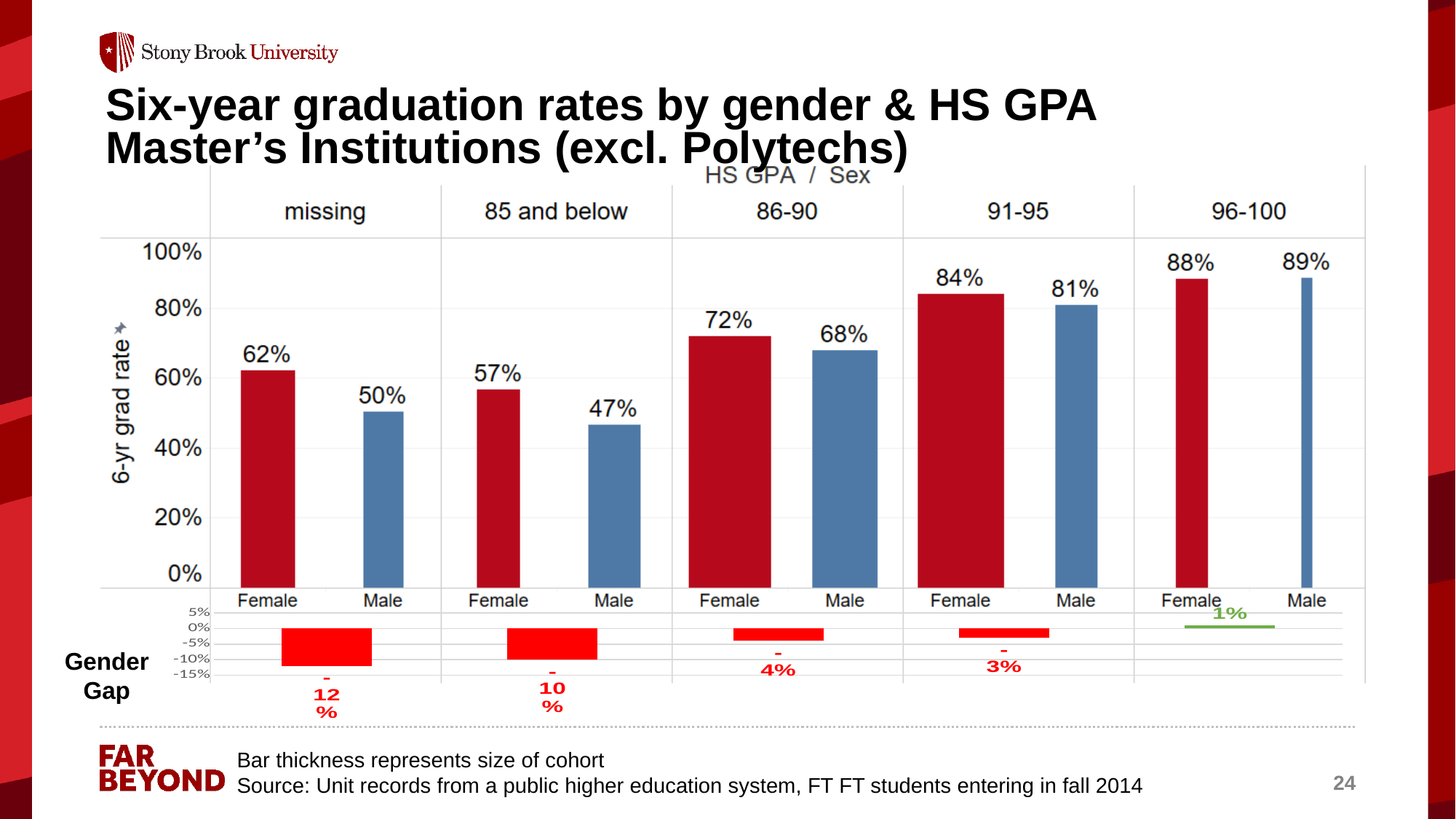
In the six-year graduation rate chart, what colour are the Female bars? Red In the six-year graduation rate chart, what is the difference between the female and male graduation rates in the 91-95 HS GPA group? 3% In the six-year graduation rate chart, what is the graduation rate for males with a HS GPA of 96-100? 89% In the six-year graduation rate chart, which HS GPA group has the lowest male graduation rate? 85 and below In the six-year graduation rate chart, which bar has the highest graduation rate overall? Male, 96-100 In the six-year graduation rate chart, which is larger in the 85 and below group: the female rate or the male rate? Female In the Gender Gap chart, what is the gender gap for the 'missing' HS GPA group? -12% In the Gender Gap chart, which HS GPA group is the only one with a positive gender gap? 96-100 In the six-year graduation rate chart, what is the graduation rate for males in the 'missing' HS GPA group? 50% What type of chart is the six-year graduation rate chart? Bar chart In the six-year graduation rate chart, what is the graduation rate for females with a HS GPA of 86-90? 72% In the six-year graduation rate chart, how many HS GPA groups are shown? 5